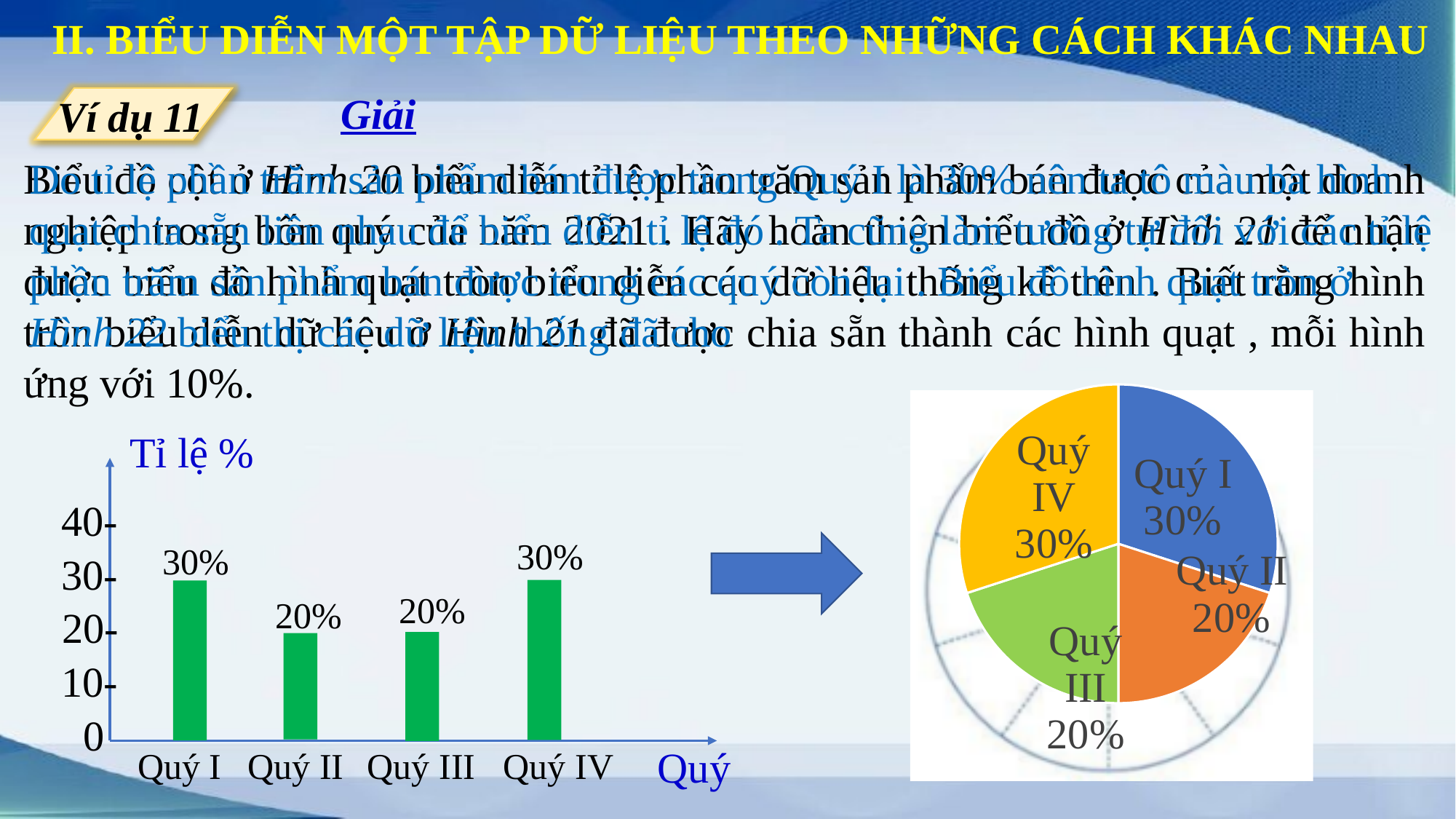
In the pie chart on the right, what share does Quý I have? 30% In the bar chart on the left, what is the value for Quý II? 20% In the bar chart on the left, what is the value for Quý IV? 30% What kind of chart is the chart on the left of the slide? bar chart How many categories are shown in the bar chart on the left? 4 In the bar chart on the left, what is the difference between the values for Quý I and Quý III? 10% What is the label on the vertical axis of the bar chart on the left? Tỉ lệ % What kind of chart is the chart on the right of the slide? pie chart In the bar chart on the left, which is larger, the value for Quý I or the value for Quý II? Quý I In the bar chart on the left, is the value for Quý IV greater or less than 20? greater How many slices does the pie chart on the right have? 4 In the pie chart on the right, what share does Quý III have? 20%